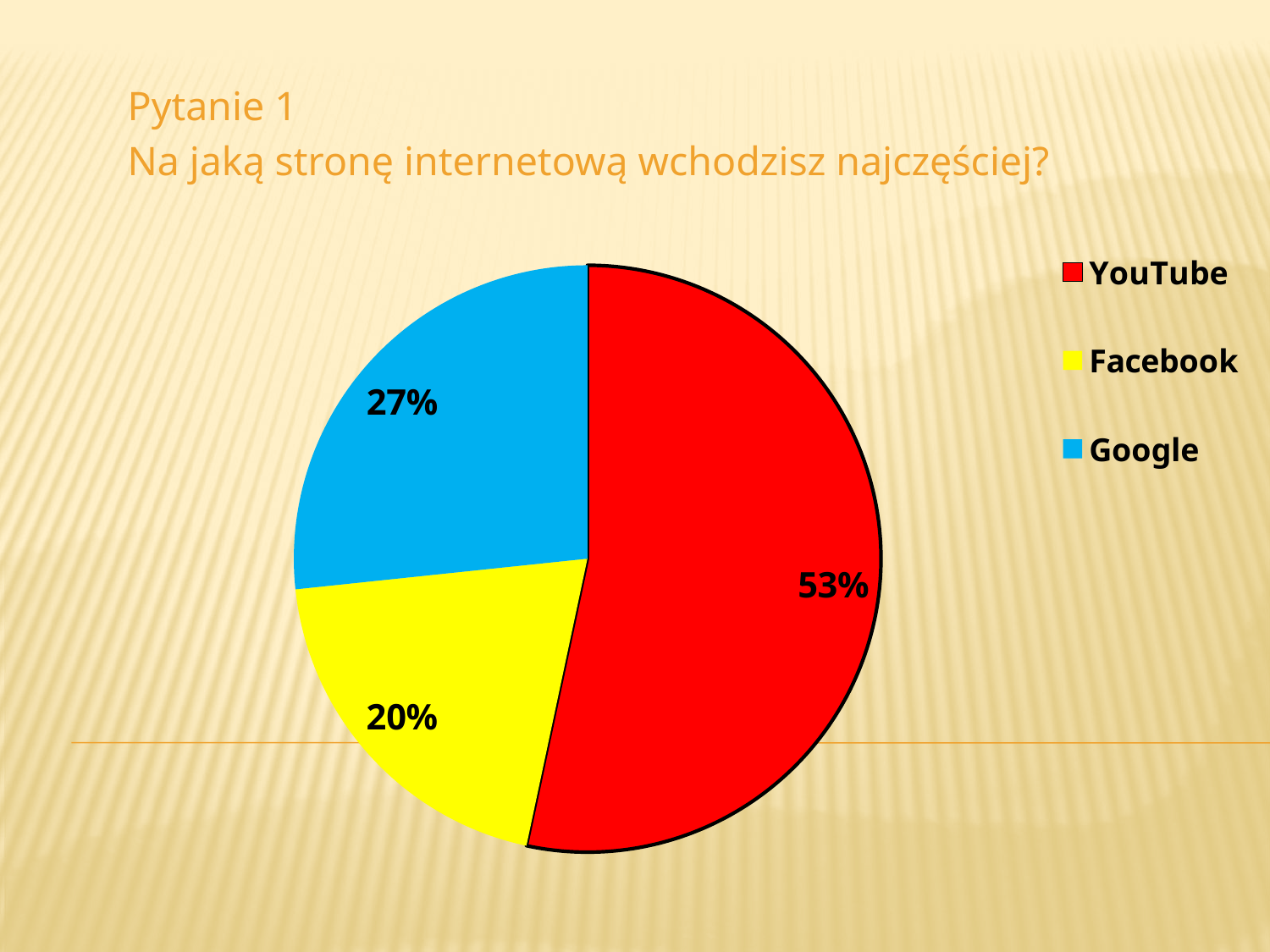
What is the question shown as the title above the chart? Na jaką stronę internetową wchodzisz najczęściej? What is the difference in percentage points between Google and Facebook? 7 How many slices does the pie chart have? 3 What share of the pie does YouTube have? 53% Which colour represents Facebook in the chart? yellow What share of the pie does Google have? 27% Which website has the largest slice of the pie? YouTube What is the difference in percentage points between YouTube and Google? 26 Which website has the smallest slice of the pie? Facebook What share of the pie does Facebook have? 20% What kind of chart is shown on the slide? pie chart Which is larger, the share for Google or the share for Facebook? Google